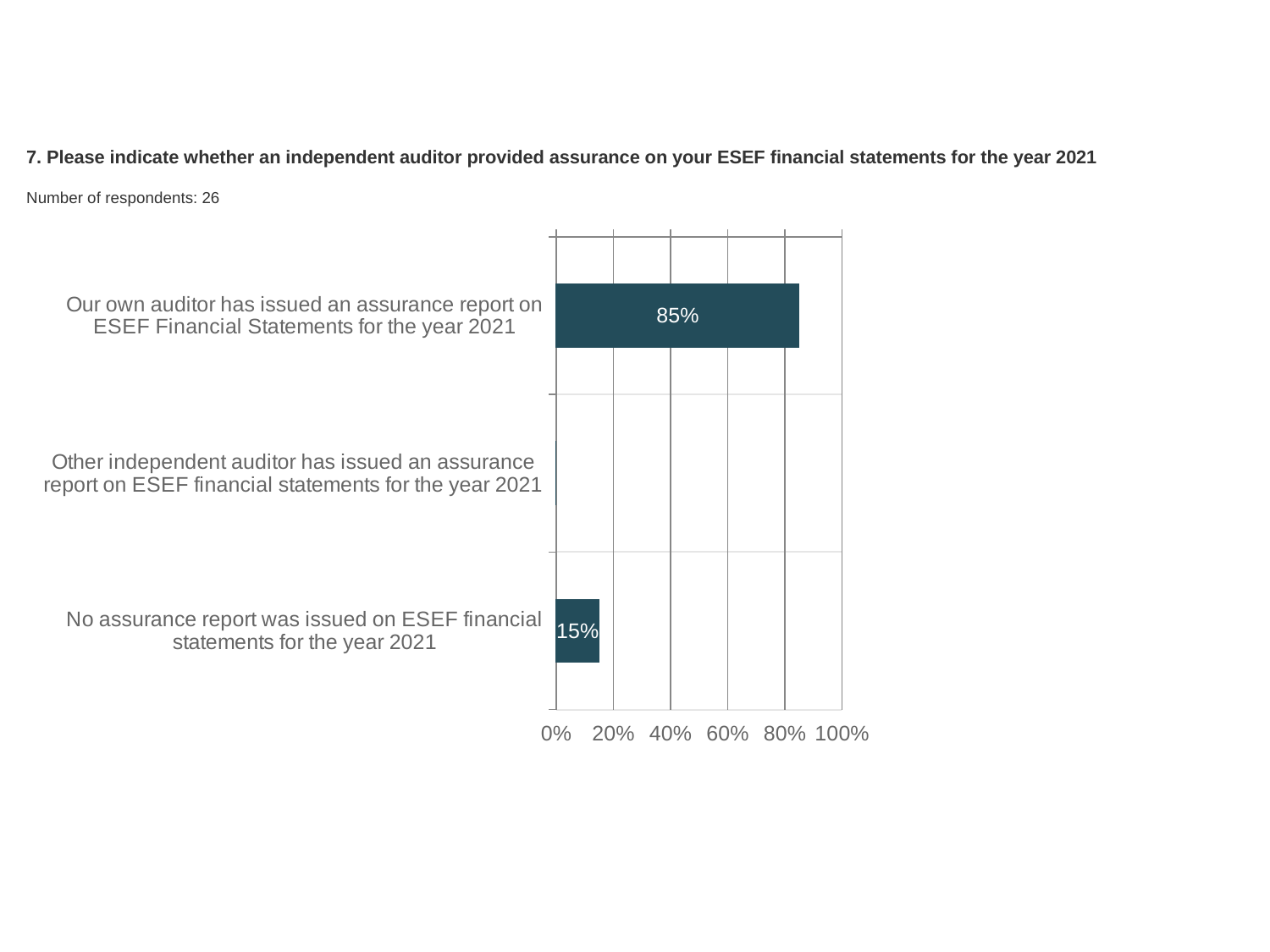
Is the value for 'Other independent auditor has issued an assurance report' greater or less than 20%? less Which category has the highest value in the chart? Our own auditor has issued an assurance report on ESEF Financial Statements for the year 2021 What kind of chart is shown on the slide? bar chart What percentage of respondents said their own auditor has issued an assurance report on ESEF Financial Statements for the year 2021? 85% How many categories are shown in the chart? 3 How many respondents does the slide say answered the question? 26 What is the difference between the value for 'Our own auditor has issued an assurance report' and the value for 'No assurance report was issued'? 70% Which category has the lowest value in the chart? Other independent auditor has issued an assurance report on ESEF financial statements for the year 2021 What percentage of respondents said no assurance report was issued on ESEF financial statements for the year 2021? 15% Which is larger: the value for 'Our own auditor has issued an assurance report' or the value for 'No assurance report was issued'? Our own auditor has issued an assurance report on ESEF Financial Statements for the year 2021 Is the value for 'Our own auditor has issued an assurance report' greater or less than 80%? greater What is the highest value shown on the horizontal axis of the chart? 100%